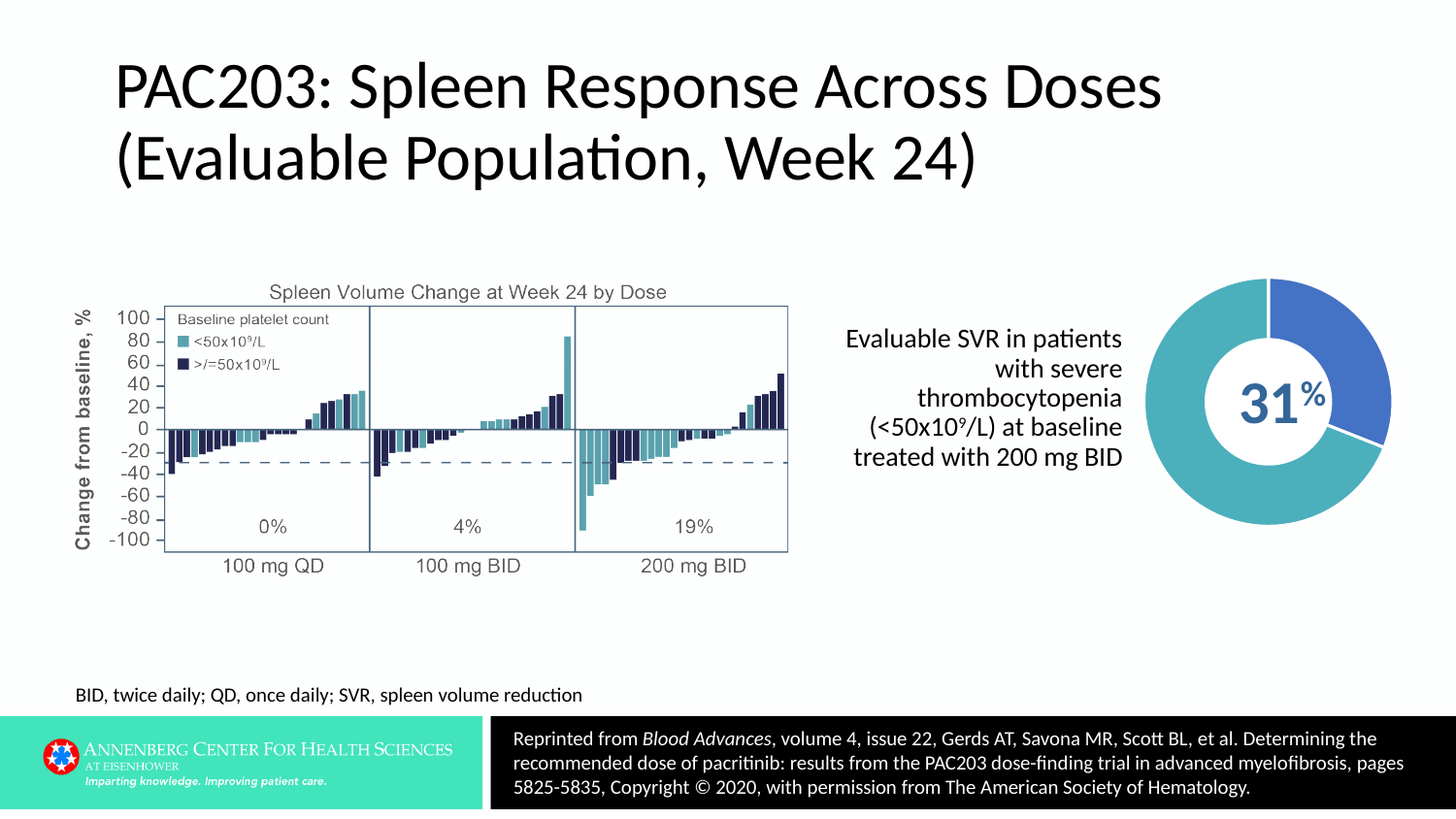
In the 'Spleen Volume Change at Week 24 by Dose' chart, which dose group has the lowest printed percentage? 100 mg QD In the 'Spleen Volume Change at Week 24 by Dose' chart, how many baseline platelet count categories does the legend list? 2 In the 'Spleen Volume Change at Week 24 by Dose' chart, what percentage is printed for the 100 mg QD dose group? 0% In the 'Spleen Volume Change at Week 24 by Dose' chart, which dose group has the highest printed percentage? 200 mg BID In the 'Spleen Volume Change at Week 24 by Dose' chart, what is the difference between the percentages printed for 200 mg BID and 100 mg BID? 15 percentage points In the 'Spleen Volume Change at Week 24 by Dose' chart, is the tallest positive bar in the 200 mg BID panel greater or less than 60? less What percentage is shown in the donut chart on the right of the slide? 31% In the 'Spleen Volume Change at Week 24 by Dose' chart, what percentage is printed for the 100 mg BID dose group? 4% What kind of chart is 'Spleen Volume Change at Week 24 by Dose'? Bar chart What is the y-axis label of the 'Spleen Volume Change at Week 24 by Dose' chart? Change from baseline, % In the 'Spleen Volume Change at Week 24 by Dose' chart, what percentage is printed for the 200 mg BID dose group? 19% How many dose groups are shown in the 'Spleen Volume Change at Week 24 by Dose' chart? 3